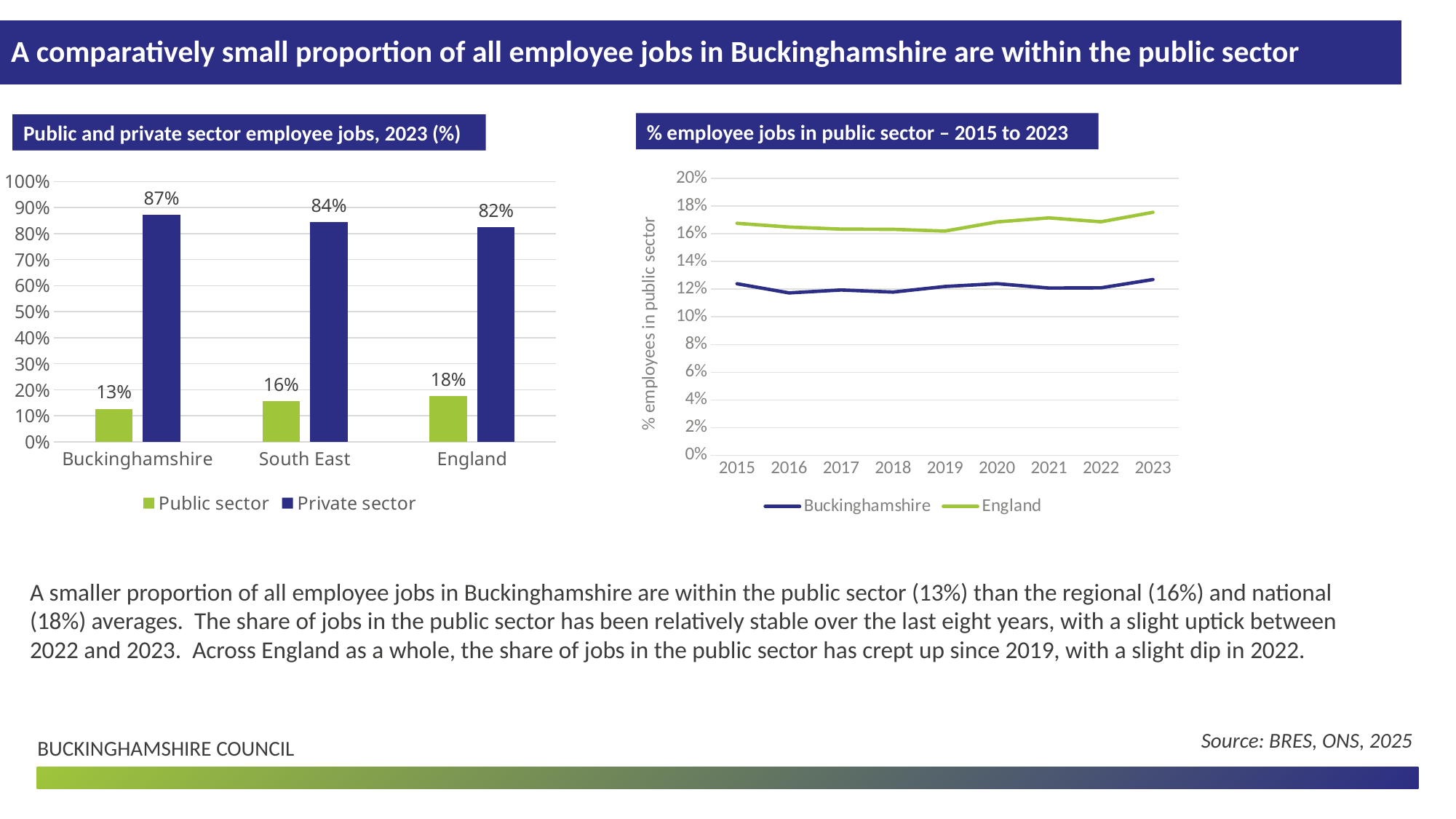
In the 'Public and private sector employee jobs, 2023 (%)' chart, how many areas are shown on the x axis? 3 In the 'Public and private sector employee jobs, 2023 (%)' chart, which area has the highest public sector share? England In the 'Public and private sector employee jobs, 2023 (%)' chart, is the public sector value for South East larger or smaller than that for England? smaller In the 'Public and private sector employee jobs, 2023 (%)' chart, what is the difference between the private sector values for Buckinghamshire and England? 5 percentage points In the '% employee jobs in public sector – 2015 to 2023' chart, is the England value for 2023 greater or less than 16%? greater In the 'Public and private sector employee jobs, 2023 (%)' chart, what is the private sector value for South East? 84% In the '% employee jobs in public sector – 2015 to 2023' chart, is the Buckinghamshire value for 2016 greater or less than 14%? less In the 'Public and private sector employee jobs, 2023 (%)' chart, how many series does the legend list? 2 In the 'Public and private sector employee jobs, 2023 (%)' chart, which area has the lowest private sector share? England In the 'Public and private sector employee jobs, 2023 (%)' chart, what is the public sector value for Buckinghamshire? 13% What type of chart is '% employee jobs in public sector – 2015 to 2023'? line chart In the '% employee jobs in public sector – 2015 to 2023' chart, which series is plotted in green? England